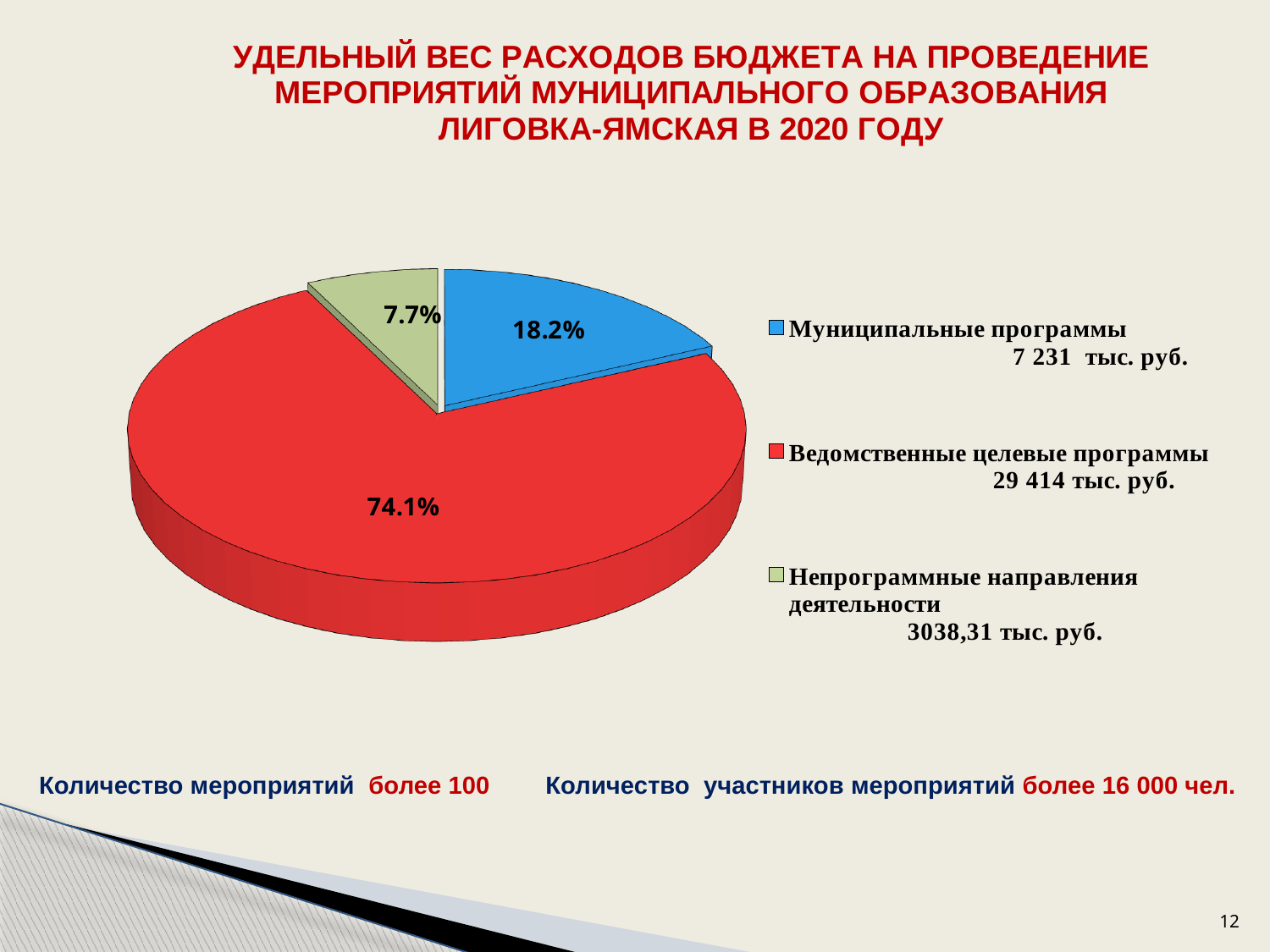
What share of the pie does Непрограммные направления деятельности represent? 7.7% Which colour represents Муниципальные программы in the pie chart? Blue How many entries does the legend list? 3 What is the difference in percentage points between the shares of Ведомственные целевые программы and Муниципальные программы? 55.9 Which category has the smallest share of the pie? Непрограммные направления деятельности What amount in тыс. руб. is shown in the legend for Муниципальные программы? 7 231 тыс. руб. How many slices does the pie chart have? 3 What share of the pie does Муниципальные программы represent? 18.2% What amount in тыс. руб. is shown in the legend for Ведомственные целевые программы? 29 414 тыс. руб. What share of the pie does Ведомственные целевые программы represent? 74.1% What kind of chart is shown on the slide? Pie chart Which category has the largest share of the pie? Ведомственные целевые программы